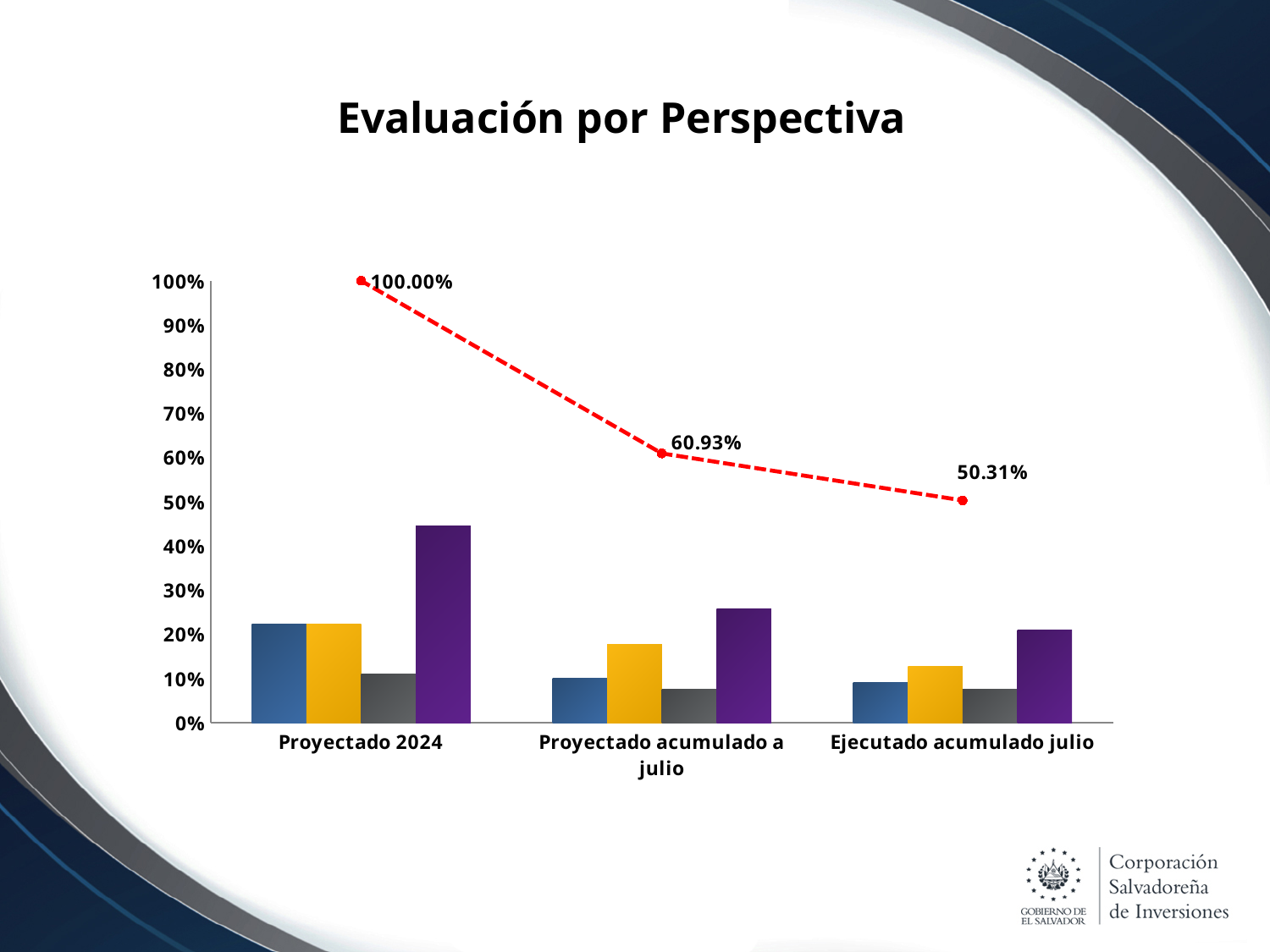
What is the value of the red dashed line for Proyectado 2024? 100.00% What is the difference between the red line values for Proyectado acumulado a julio and Ejecutado acumulado julio? 10.62% Which category has the lowest value on the red dashed line? Ejecutado acumulado julio Is the value of the purple bar for Proyectado 2024 greater or less than 40%? greater How many categories are shown on the x axis? 3 Is the value of the yellow bar for Ejecutado acumulado julio greater or less than 20%? less What is the difference between the red line values for Proyectado 2024 and Proyectado acumulado a julio? 39.07% What is the value of the red dashed line for Ejecutado acumulado julio? 50.31% Which category has the highest value on the red dashed line? Proyectado 2024 Does the red dashed line rise or fall from left to right across the categories? fall What is the value of the red dashed line for Proyectado acumulado a julio? 60.93% What is the title of the chart? Evaluación por Perspectiva